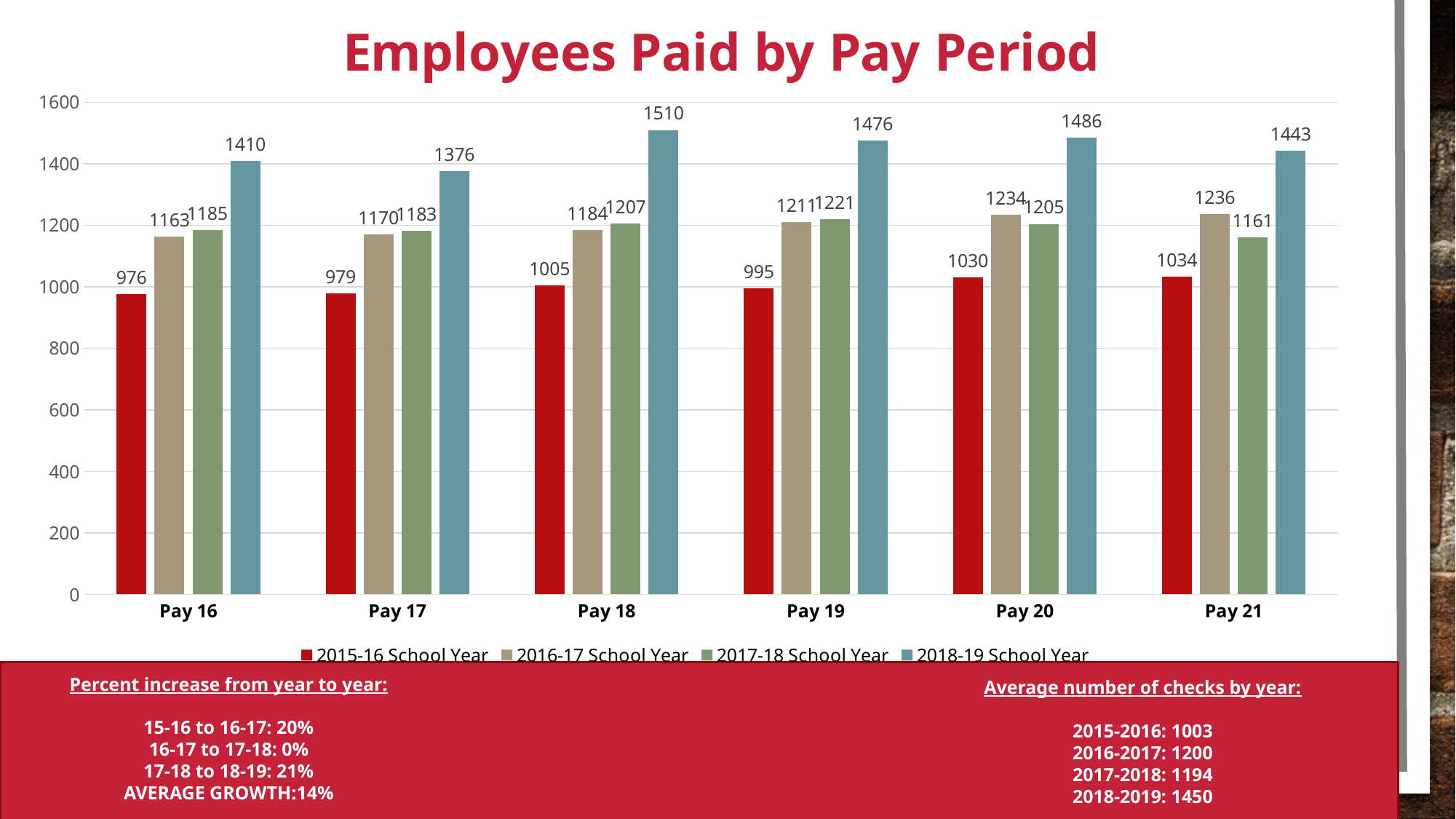
Which pay period has the lowest value in the 2015-16 School Year series? Pay 16 Is the value for Pay 17 in the 2018-19 School Year series greater or less than 1200? greater What is the value for Pay 18 in the 2018-19 School Year series? 1510 What is the value for Pay 21 in the 2017-18 School Year series? 1161 What is the difference between the 2018-19 School Year and 2015-16 School Year values for Pay 20? 456 What kind of chart is shown on the slide? bar chart For Pay 21, which is larger: the 2016-17 School Year value or the 2017-18 School Year value? 2016-17 School Year What is the value for Pay 16 in the 2015-16 School Year series? 976 What is the title of the chart? Employees Paid by Pay Period How many series does the legend list? 4 Which pay period has the highest value in the 2018-19 School Year series? Pay 18 How many pay periods are shown on the x axis? 6